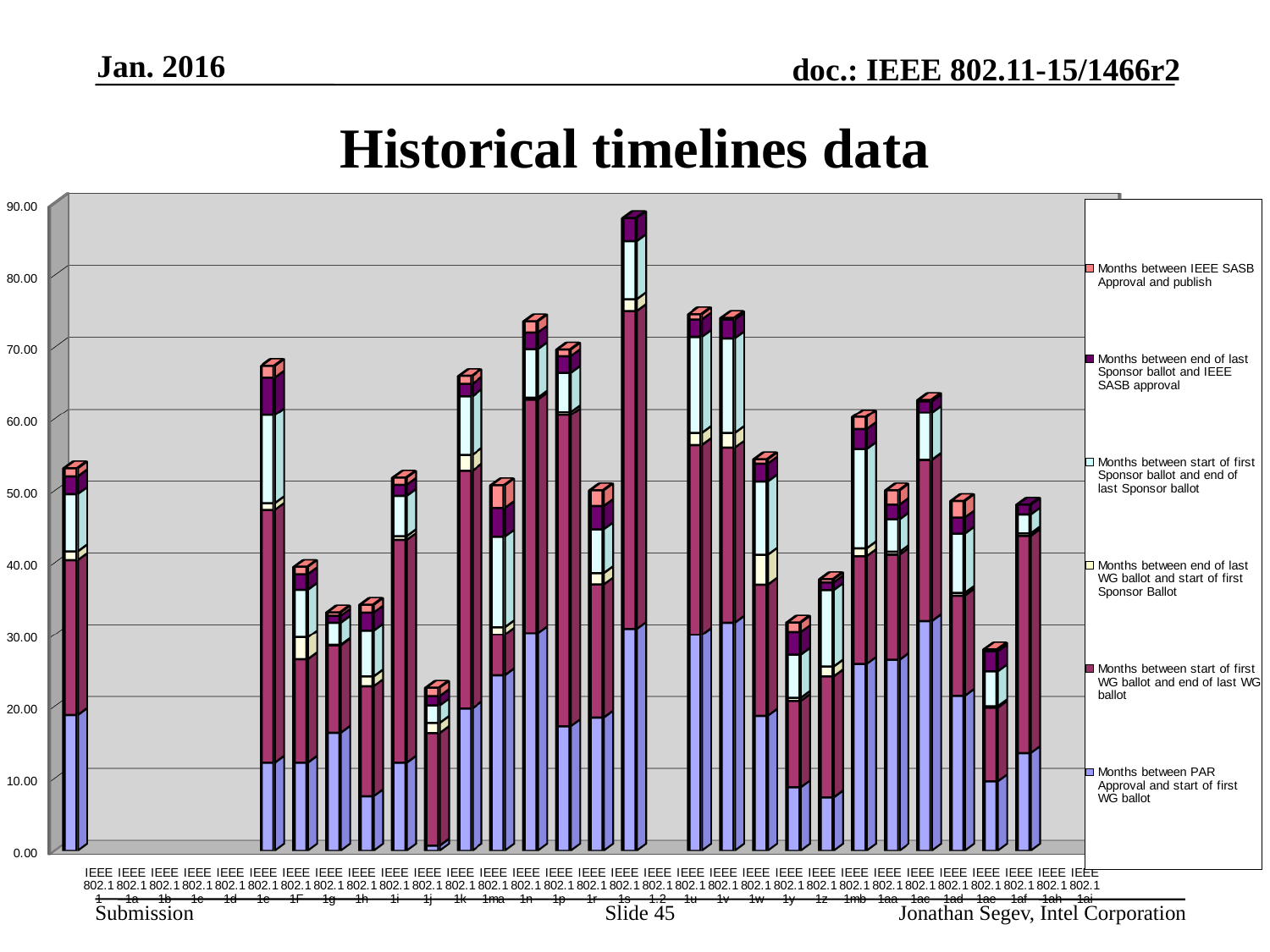
What is the highest value shown on the vertical axis? 90.00 Which legend entry corresponds to the bottom segment of each stacked bar? Months between PAR Approval and start of first WG ballot Is the total of the shortest stacked bar greater or less than 30? less Is the total of the tallest stacked bar greater or less than 90? less Is the total of the tallest stacked bar greater or less than 80? greater What kind of chart is shown on the slide? Stacked bar chart What is the title of the chart? Historical timelines data How many series does the legend list? 6